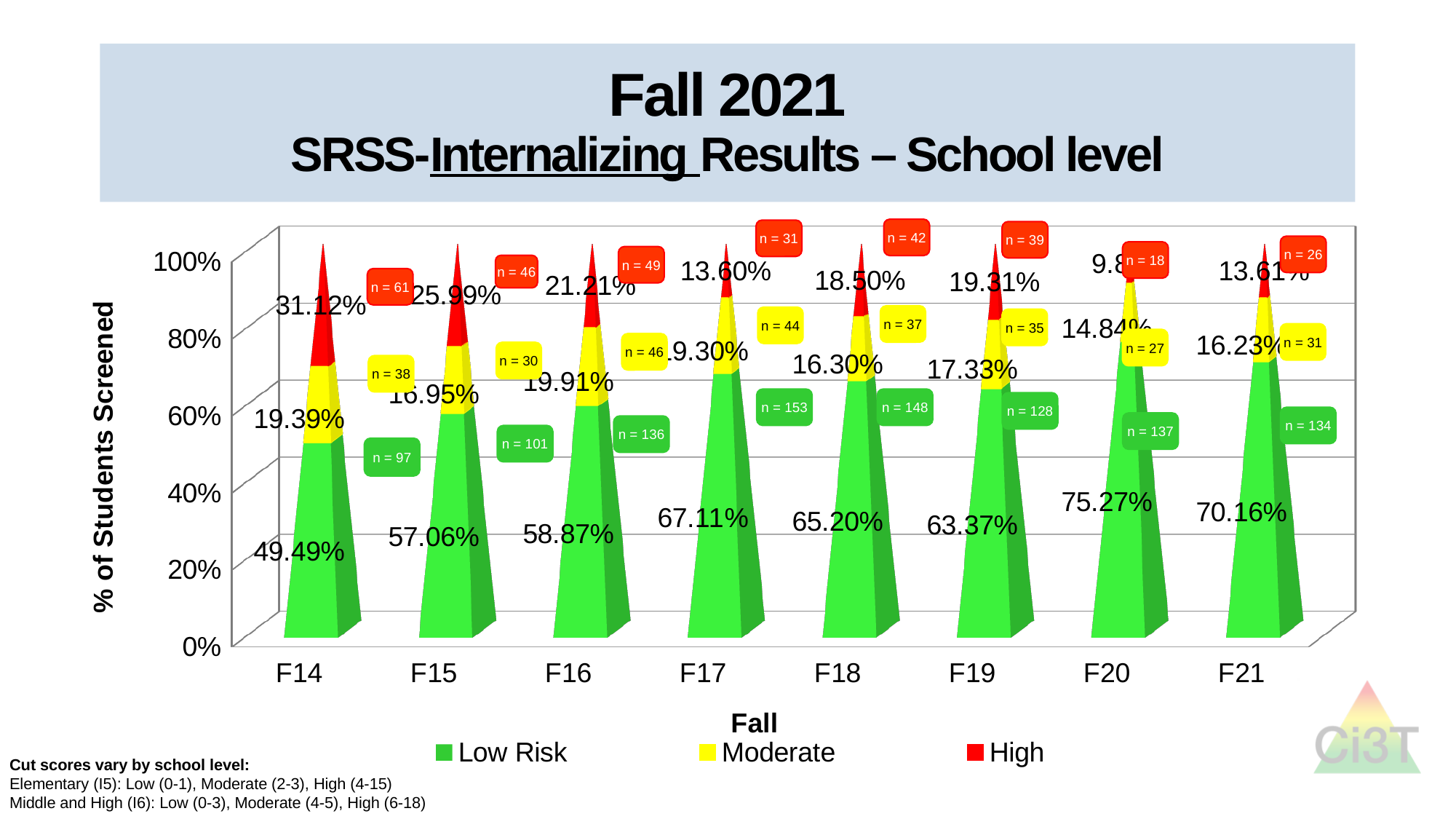
What is the difference between the Low Risk percentage for F21 and for F14? 20.67% Which fall has the highest High percentage? F14 How many fall periods are shown on the x axis? 8 How many series does the legend list? 3 What is the Moderate percentage for F16? 19.91% Which has a larger Low Risk percentage, F17 or F18? F17 Which fall has the lowest Low Risk percentage? F14 Which fall has the highest Low Risk percentage? F20 What is the Low Risk percentage for F14? 49.49% Does the Low Risk percentage rise or fall from F14 to F17? rise What is the n value shown for the Low Risk group in F17? n = 153 What is the High percentage for F14? 31.12%